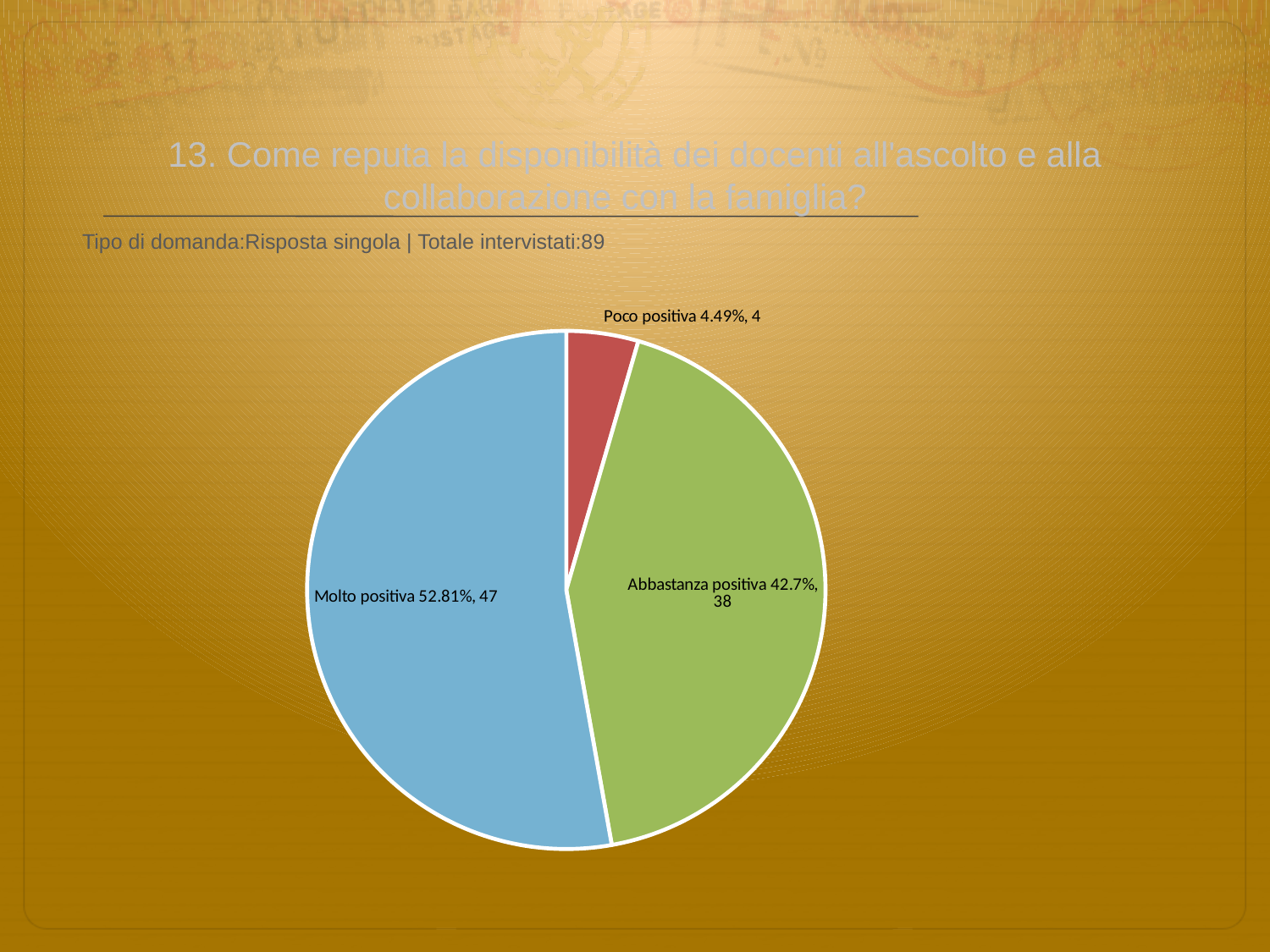
What is the difference in respondent count between 'Molto positiva' and 'Abbastanza positiva'? 9 What percentage share does the 'Molto positiva' slice have? 52.81% How many slices does the pie chart have? 3 What colour is the 'Poco positiva' slice? red What percentage share does the 'Abbastanza positiva' slice have? 42.7% How many respondents chose 'Abbastanza positiva'? 38 Which category has the smallest slice of the pie? Poco positiva Which has more respondents, 'Abbastanza positiva' or 'Poco positiva'? Abbastanza positiva Which category has the largest slice of the pie? Molto positiva What kind of chart is shown on the slide? pie chart How many respondents chose 'Poco positiva'? 4 What is the total number of respondents across all three slices? 89